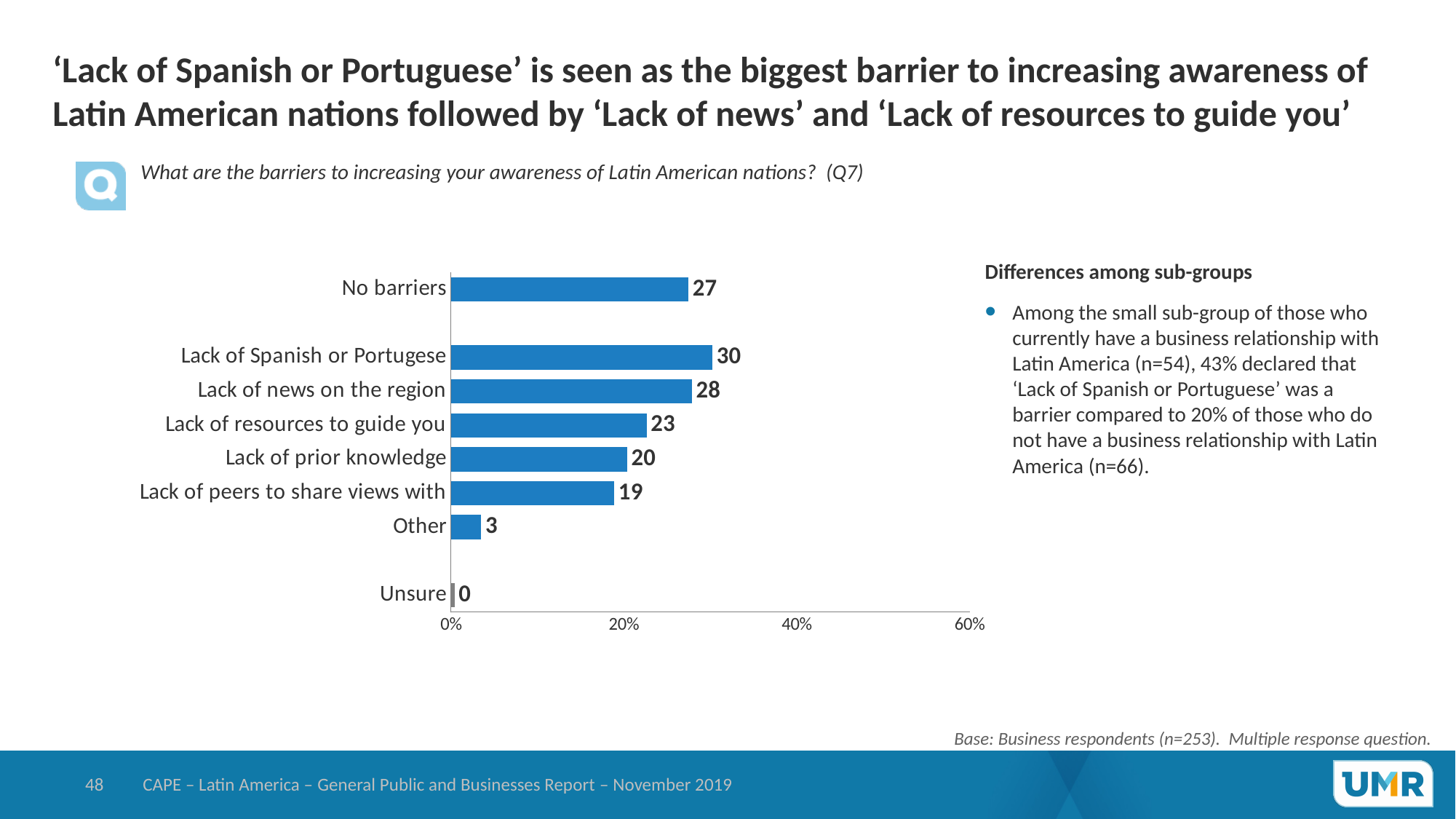
Which category has the lowest value? Unsure Is the value for 'Lack of Spanish or Portugese' greater or less than 20%? greater Which is larger, 'Lack of prior knowledge' or 'No barriers'? No barriers What is the difference between 'Lack of news on the region' and 'Lack of resources to guide you'? 5 What is the value for 'Lack of peers to share views with'? 19 What is the value for 'Unsure'? 0 What is the value for 'Lack of Spanish or Portugese'? 30 What kind of chart is shown on the slide? bar chart How many categories are shown in the chart? 8 Which category has the highest value? Lack of Spanish or Portugese What is the value for 'No barriers'? 27 What is the highest value shown on the x axis? 60%